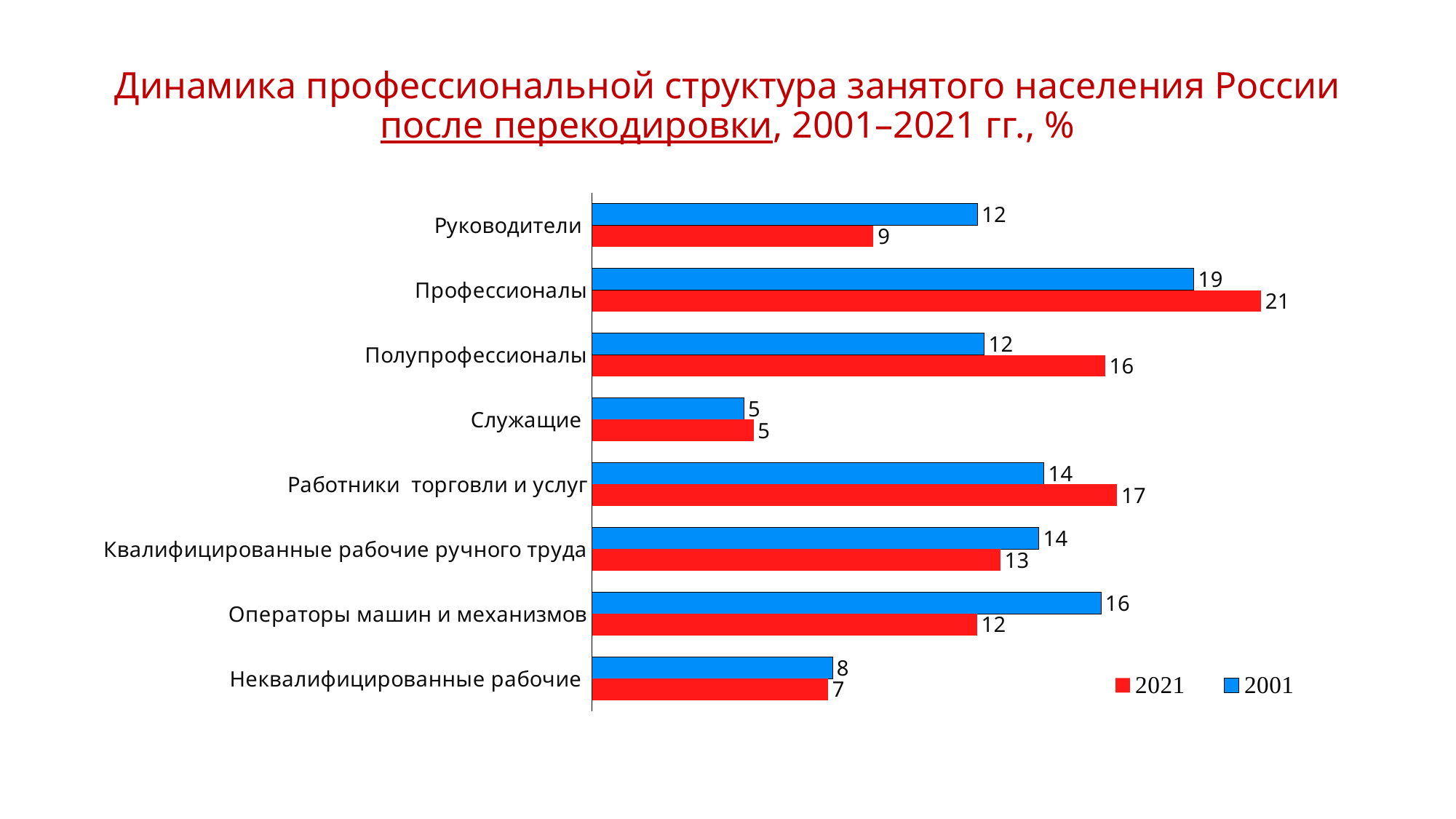
Which category has the highest 2021 value? Профессионалы What is the 2001 value for Операторы машин и механизмов? 16 Which is larger for Операторы машин и механизмов: the 2001 value or the 2021 value? 2001 What is the difference between the 2021 and 2001 values for Полупрофессионалы? 4 Which category has the lowest 2001 value? Служащие What is the 2021 value for Руководители? 9 How many series does the legend list? 2 What is the difference between the 2001 and 2021 values for Руководители? 3 What is the 2021 value for Профессионалы? 21 What kind of chart is shown on the slide? Bar chart How many categories are shown on the chart? 8 Which colour represents the 2021 series? Red